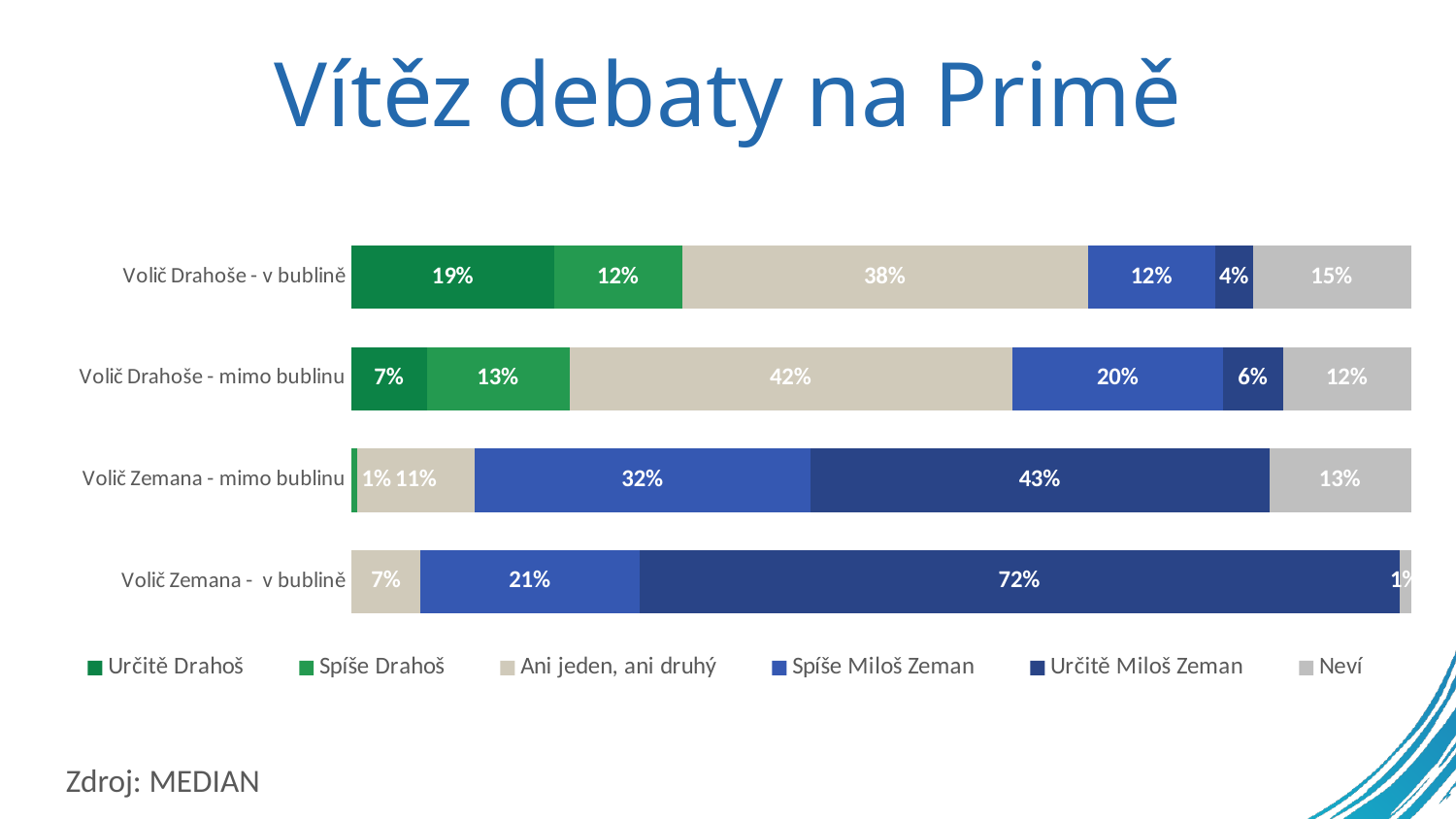
How many voter groups (categories) are plotted in the chart? 4 What is the value of 'Určitě Miloš Zeman' for 'Volič Zemana - v bublině'? 72% What is the difference in 'Spíše Miloš Zeman' between 'Volič Drahoše - mimo bublinu' and 'Volič Drahoše - v bublině'? 8 percentage points What is the value of 'Neví' for 'Volič Zemana - mimo bublinu'? 13% Which has the larger 'Spíše Drahoš' value: 'Volič Drahoše - v bublině' or 'Volič Drahoše - mimo bublinu'? Volič Drahoše - mimo bublinu Which category has the lowest value for 'Ani jeden, ani druhý'? Volič Zemana - v bublině What is the value of 'Ani jeden, ani druhý' for 'Volič Drahoše - mimo bublinu'? 42% What is the title of the chart on the slide? Vítěz debaty na Primě How many series does the legend list? 6 What is the value of 'Určitě Drahoš' for 'Volič Drahoše - v bublině'? 19% What kind of chart is shown on the slide? Stacked bar chart Which category has the highest value for 'Určitě Miloš Zeman'? Volič Zemana - v bublině